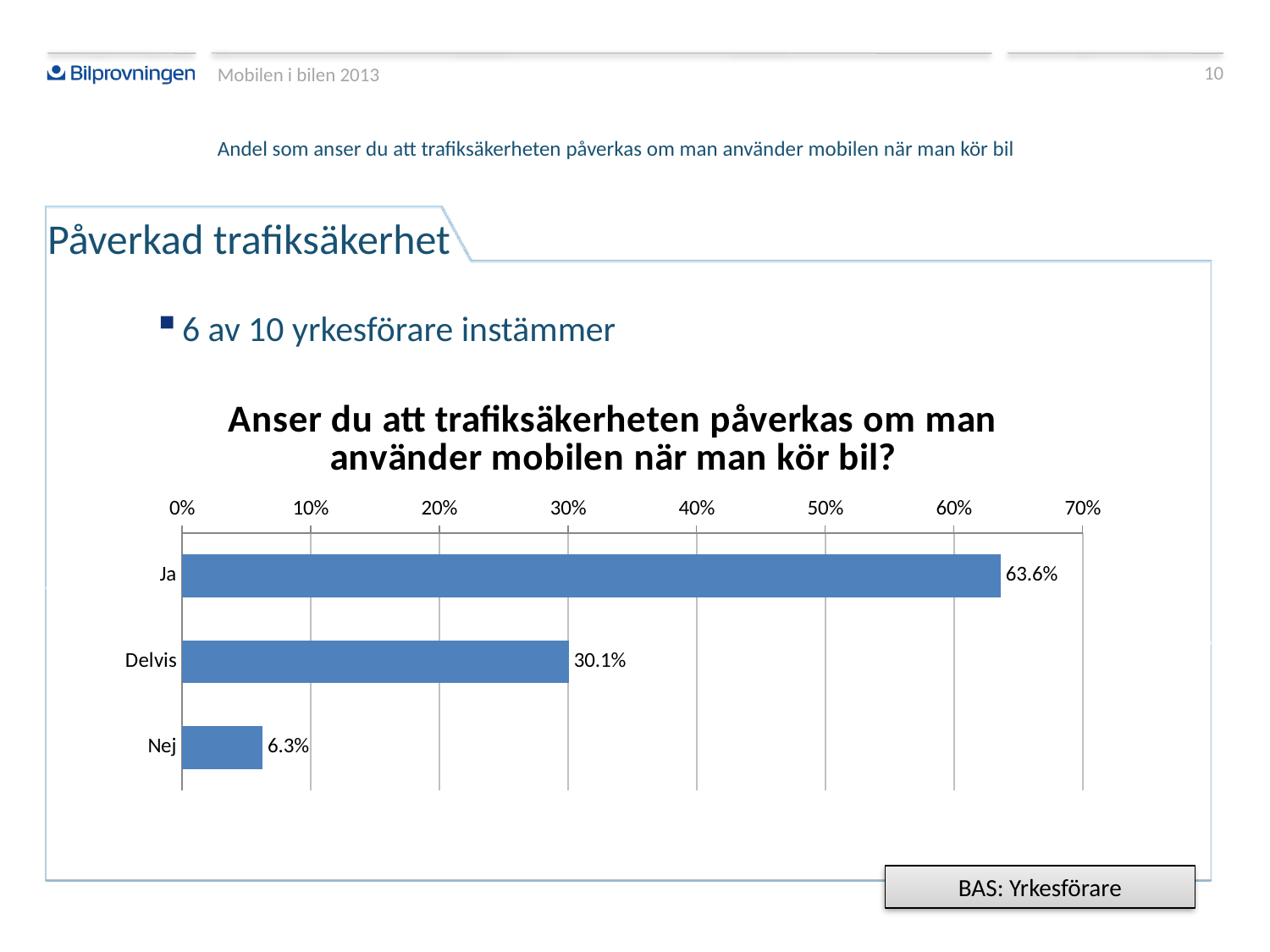
Which category has the highest value? Ja Which category has the lowest value? Nej What is the difference between the values for "Delvis" and "Nej"? 23.8% Which is larger, the value for "Delvis" or the value for "Nej"? Delvis What is the value for "Delvis"? 30.1% Is the value for "Ja" greater or less than 60%? greater What is the value for "Ja"? 63.6% How many categories are shown in the chart? 3 What kind of chart is shown on the slide? Bar chart What is the difference between the values for "Ja" and "Delvis"? 33.5% What is the title of the chart? Anser du att trafiksäkerheten påverkas om man använder mobilen när man kör bil? What is the value for "Nej"? 6.3%